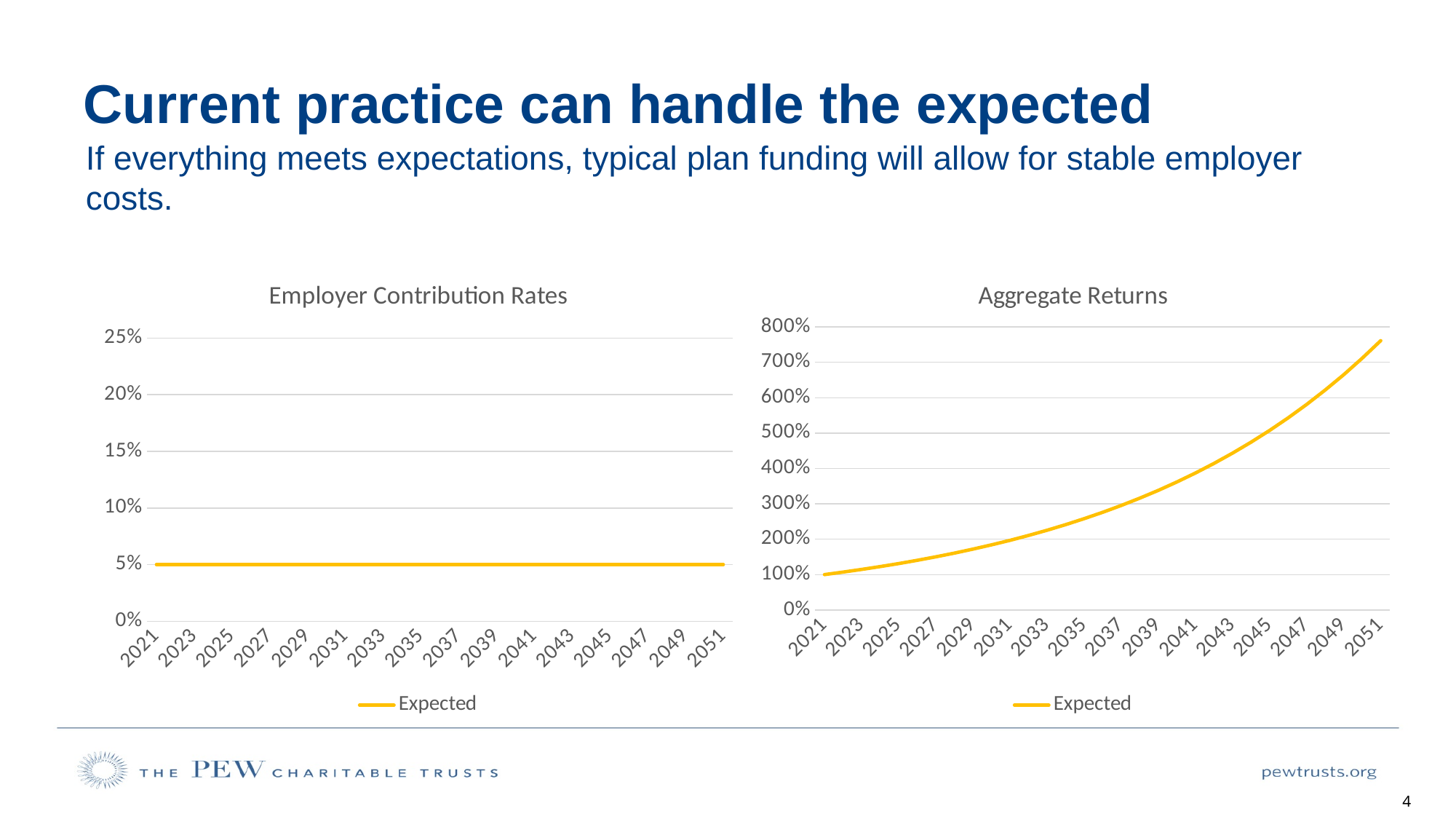
In the Employer Contribution Rates chart, what is the Expected value in 2021? 5% In the Aggregate Returns chart, which year has the highest value? 2051 What kind of chart is the Employer Contribution Rates chart? line chart In the Aggregate Returns chart, what is the Expected value in 2021? 100% In the Aggregate Returns chart, how many series does the legend list? 1 What is the name of the series shown in the legend of the Aggregate Returns chart? Expected What kind of chart is the Aggregate Returns chart? line chart In the Employer Contribution Rates chart, how many series does the legend list? 1 In the Aggregate Returns chart, is the value for 2051 greater or less than 700%? greater In the Aggregate Returns chart, do the values rise or fall from 2021 to 2051? rise In the Aggregate Returns chart, is the value for 2051 greater or less than 800%? less In the Employer Contribution Rates chart, does the Expected line rise, fall, or stay flat from 2021 to 2051? stay flat